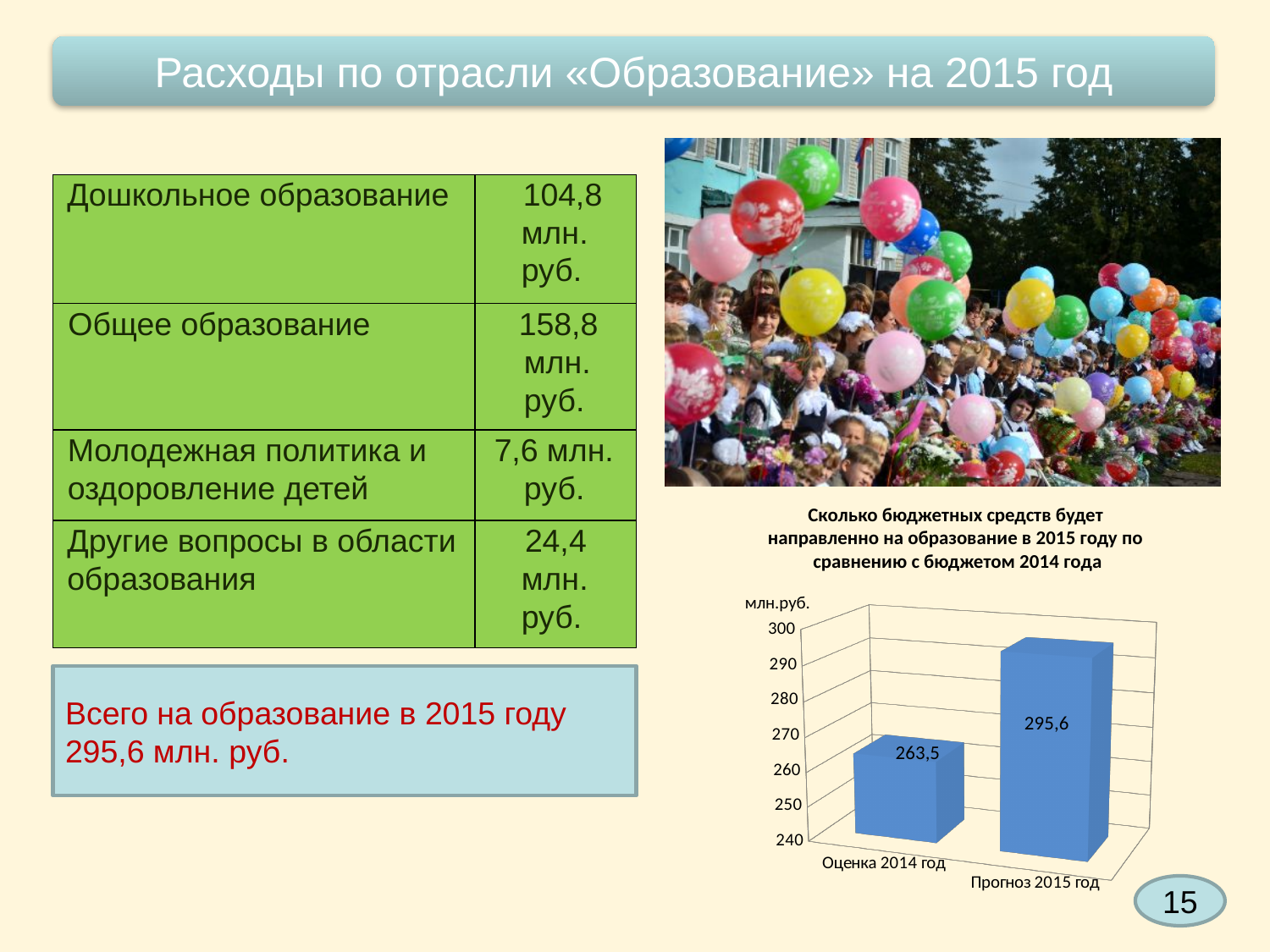
Is the value for «Оценка 2014 год» greater or less than 270? less What is the difference between the values for «Прогноз 2015 год» and «Оценка 2014 год»? 32,1 Which category has the lowest value on the chart? Оценка 2014 год Do the values rise or fall from «Оценка 2014 год» to «Прогноз 2015 год»? rise What kind of chart is shown on the slide? bar chart Which category has the highest value on the chart? Прогноз 2015 год Is the value for «Прогноз 2015 год» greater or less than 290? greater What unit is shown on the vertical axis of the chart? млн.руб. What is the value for «Оценка 2014 год» on the chart? 263,5 Which is larger: the value for «Оценка 2014 год» or for «Прогноз 2015 год»? Прогноз 2015 год What is the value for «Прогноз 2015 год» on the chart? 295,6 How many bars are plotted on the chart? 2